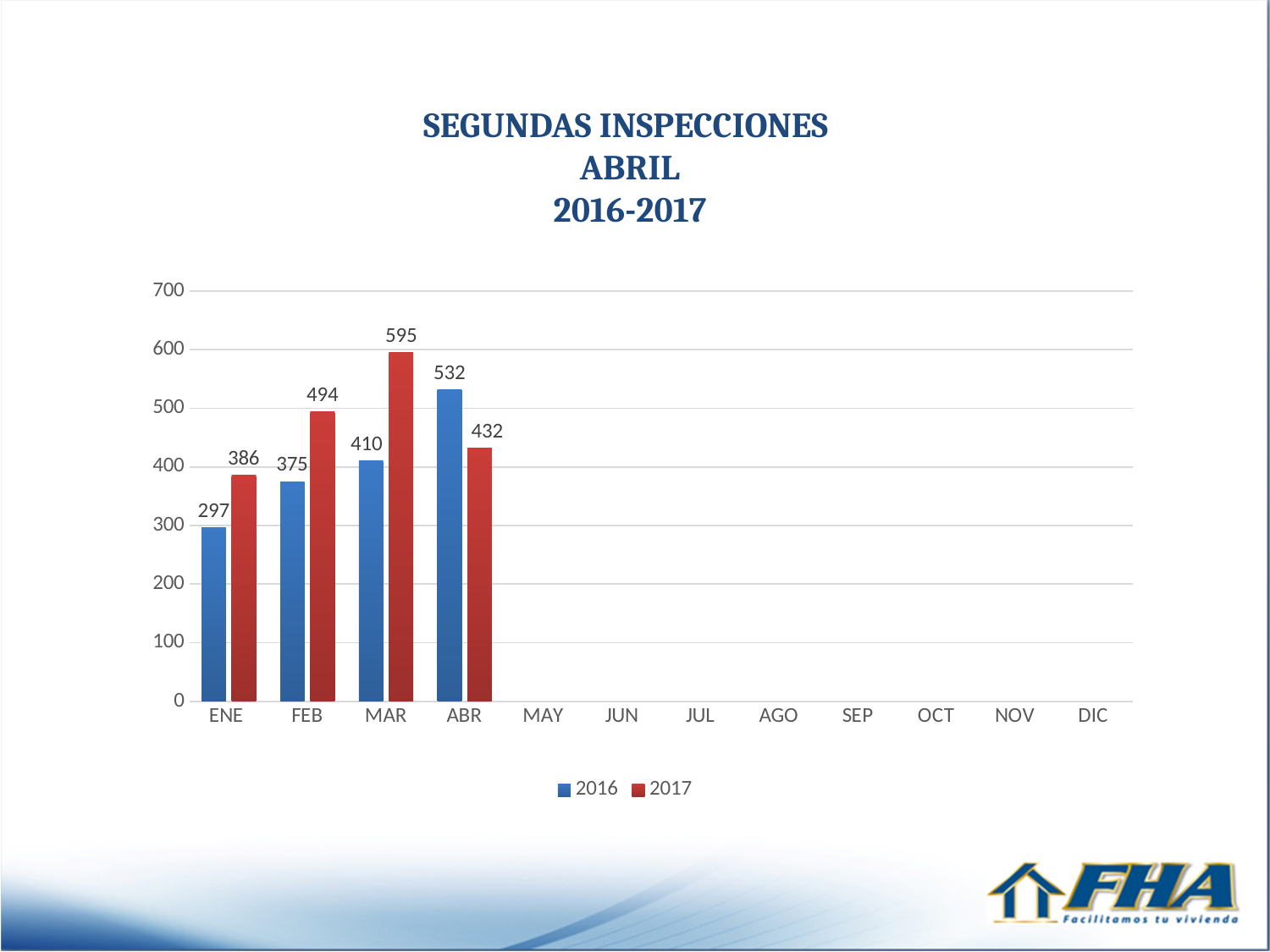
How many series does the legend list? 2 Is the value for 2016 in MAR greater or less than 500? less What is the value for 2017 in ABR? 432 What is the difference between the 2017 and 2016 values in FEB? 119 In ABR, which series has the larger value, 2016 or 2017? 2016 How many months are shown on the x axis? 12 Which month has the highest value for the 2017 series? MAR Which month has the lowest value for the 2016 series? ENE Does the 2016 series rise or fall from ENE to ABR? rise What is the value for 2017 in MAR? 595 What is the value for 2016 in ENE? 297 What kind of chart is shown on the slide? bar chart